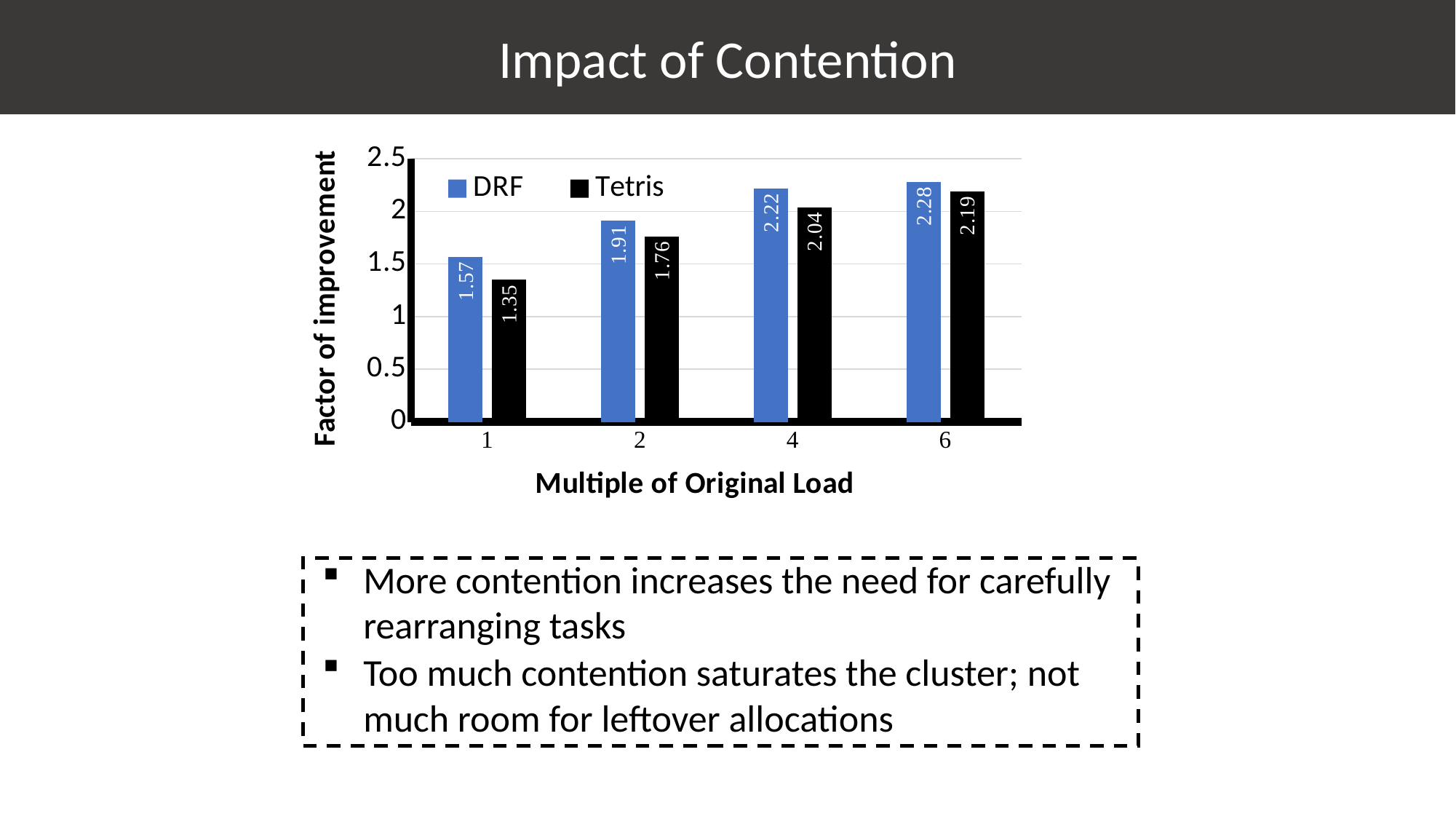
What kind of chart is shown on the slide? Bar chart Is the DRF value at a multiple of original load of 4 greater or less than 2? greater What is the Tetris value at a multiple of original load of 1? 1.35 How many series does the legend list? 2 What is the difference between the DRF and Tetris values at a multiple of original load of 6? 0.09 Do the DRF values rise or fall as the multiple of original load increases? Rise What is the DRF factor of improvement at a multiple of original load of 2? 1.91 At which multiple of original load is the DRF factor of improvement highest? 6 What is the Tetris factor of improvement at a multiple of original load of 4? 2.04 How many multiples of original load are shown on the x axis? 4 At a multiple of original load of 1, which series has the larger value, DRF or Tetris? DRF At which multiple of original load is the Tetris factor of improvement lowest? 1